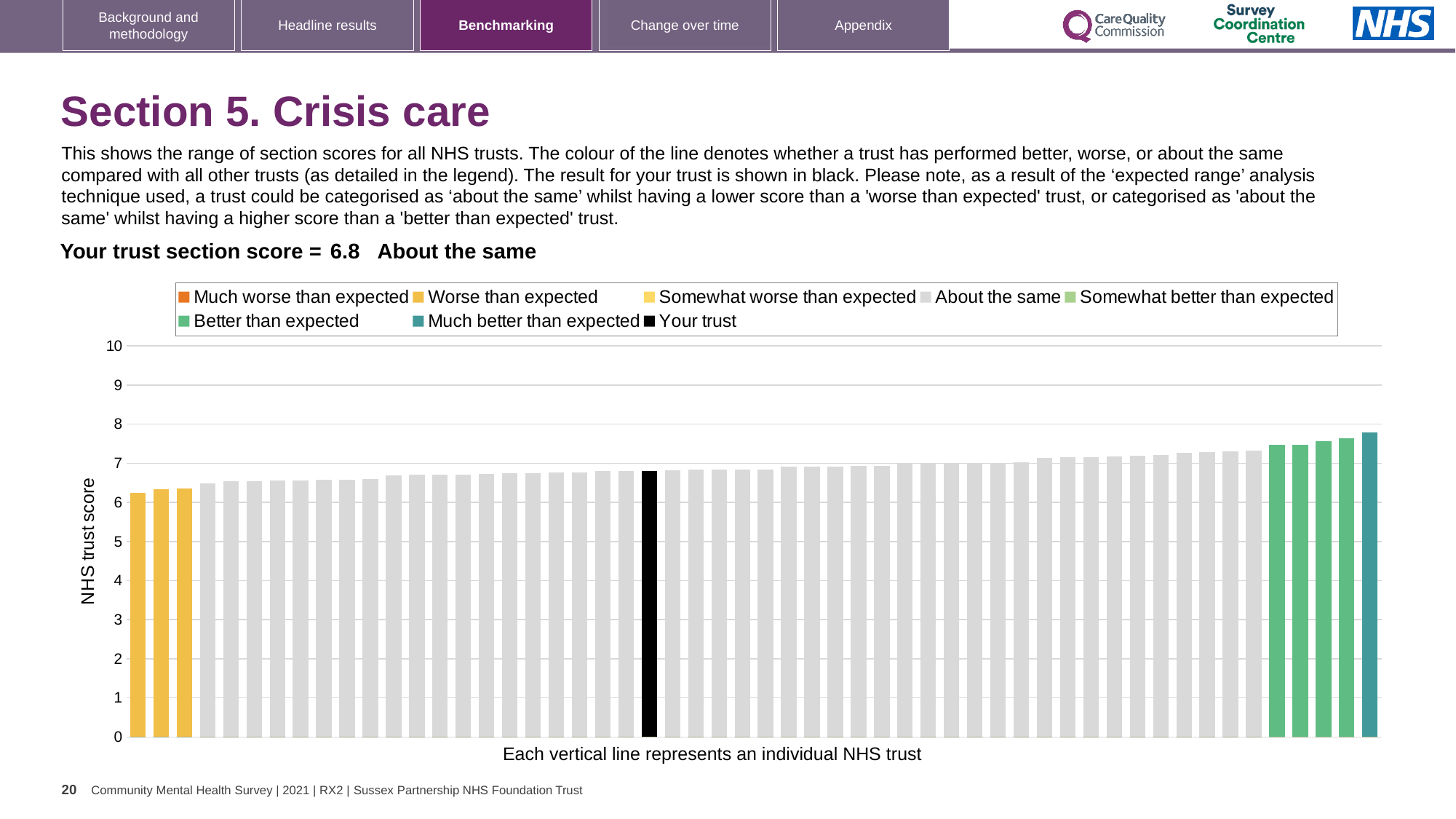
How many bars are coloured as 'Worse than expected'? 3 What is the section score for your trust shown on the slide? 6.8 Is the value of the tallest bar in the chart greater or less than 8? less Which legend category does the tallest bar belong to? Much better than expected Is the value of the shortest bar in the chart greater or less than 6? greater How many entries does the chart legend list? 8 Is the value of the black bar (your trust) greater or less than 5? greater What is the title of the vertical axis? NHS trust score How many bars are coloured as 'Better than expected'? 4 Which category is your trust placed in for the crisis care section score? About the same Do the bar values rise or fall from left to right along the x axis? rise What kind of chart is shown on the slide? bar chart